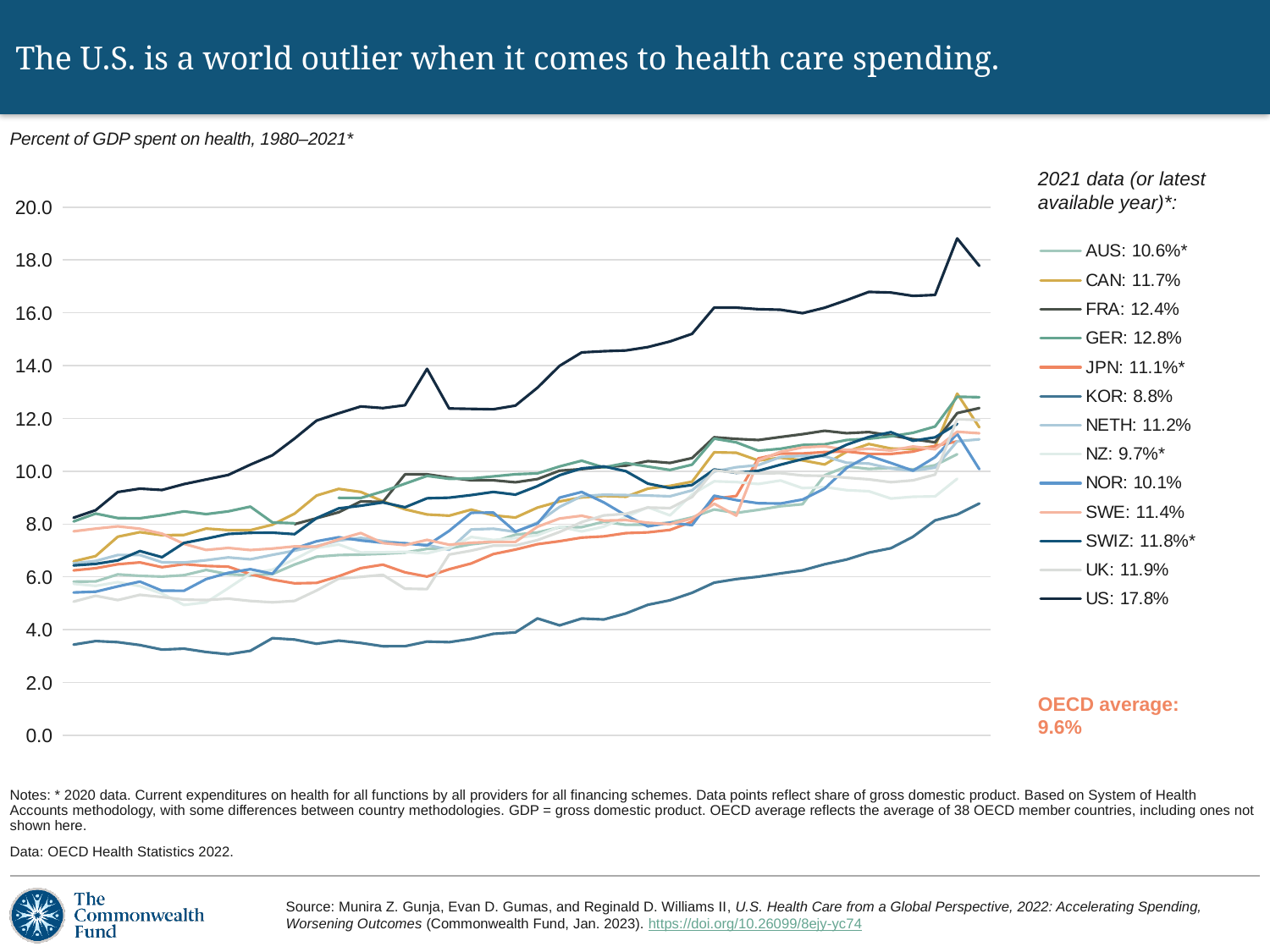
Is the value for the US in 1980 greater or less than 10.0? less What is the difference between the 2021 values for the US and GER? 5.0 percentage points Does the US line rise or fall from 1980 to 2021? Rise What kind of chart is shown on the slide? Line chart How many countries does the legend list? 13 Which country has the highest 2021 value? US Which has a higher 2021 value, FRA or CAN? FRA Which country has the lowest 2021 value? KOR What is the value shown for GER in the legend? 12.8% What is the 2021 value for the US? 17.8% What is the 2021 value for KOR? 8.8% What OECD average is shown on the slide? 9.6%